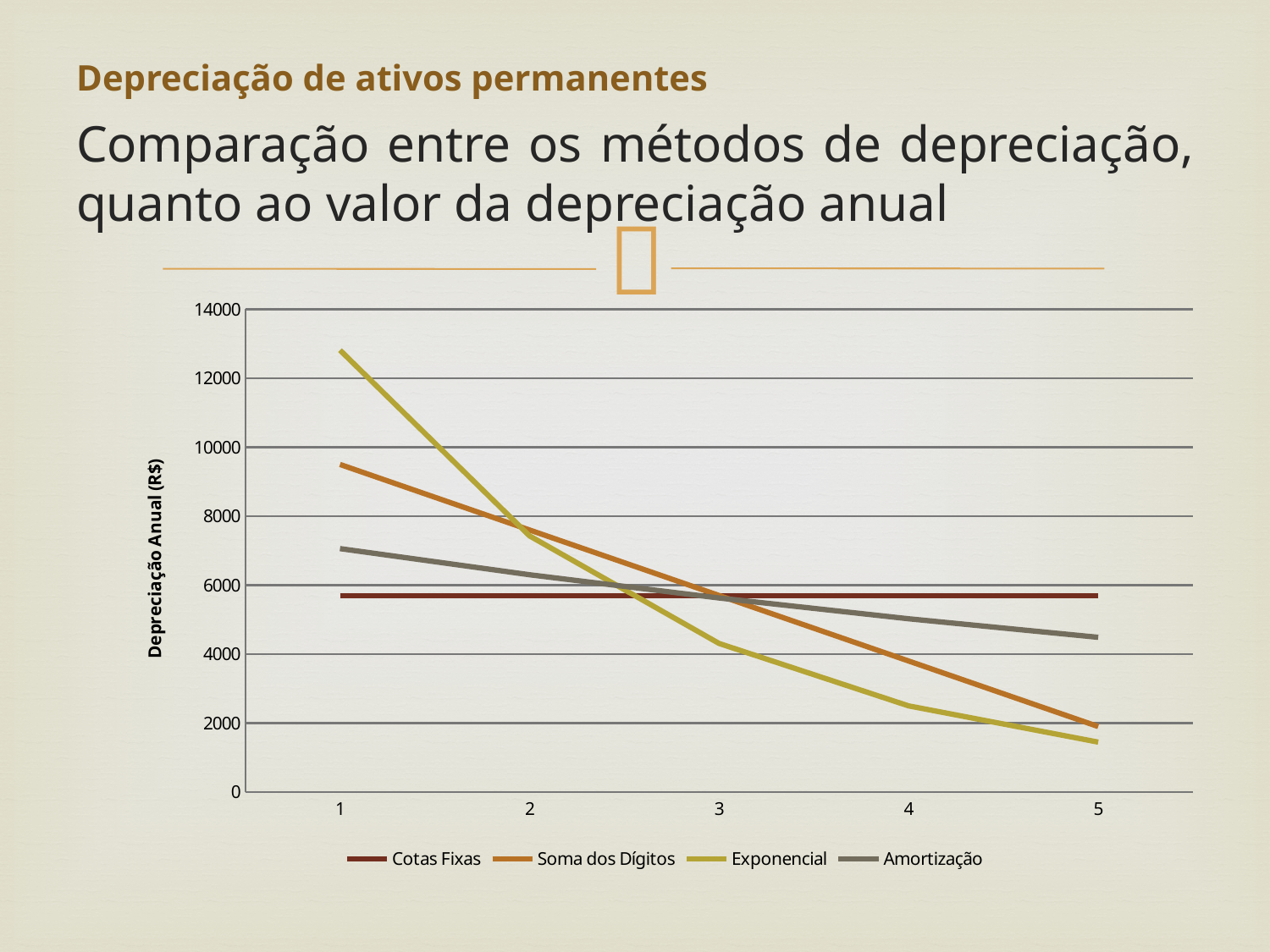
What kind of chart is shown on the slide? line chart How many series does the legend list? 4 Which series has the lowest value at year 1? Cotas Fixas What is the title of the y axis? Depreciação Anual (R$) Is the value for Exponencial at year 1 greater or less than 12000? greater Does the Cotas Fixas series rise, fall or stay flat across the years? stay flat At year 5, which is larger: Amortização or Soma dos Dígitos? Amortização How many points (years) are plotted along the x axis? 5 Does the Exponencial series rise or fall from year 1 to year 5? fall Which series has the highest value at year 1? Exponencial Is the value for Soma dos Dígitos at year 1 greater or less than 10000? less Is the value for Amortização at year 5 greater or less than 4000? greater